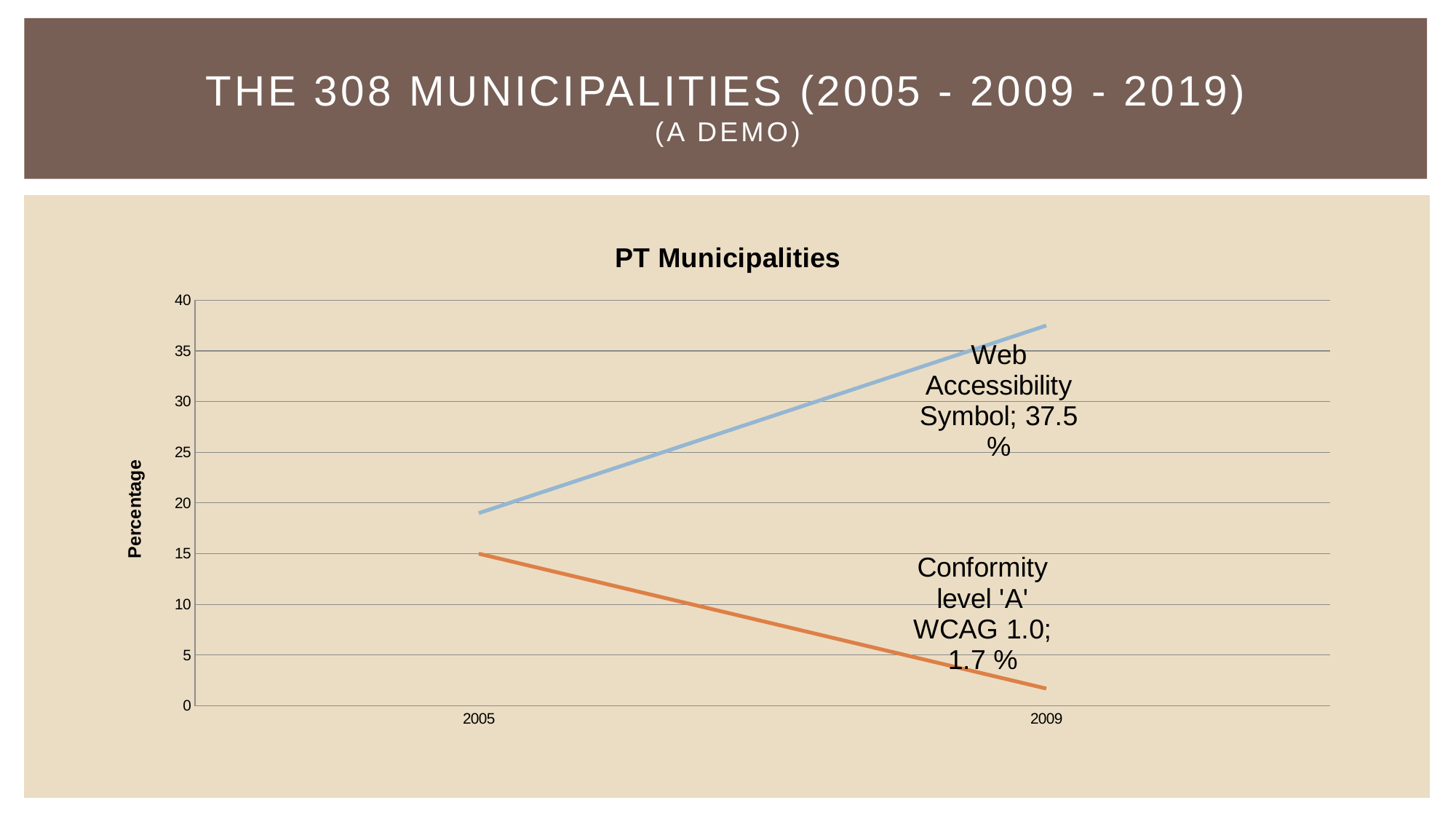
Does the Conformity level 'A' WCAG 1.0 line rise or fall from 2005 to 2009? falls Is the value for Conformity level 'A' WCAG 1.0 in 2005 greater or less than 10? greater How many years are shown on the x axis? 2 Is the value for Web Accessibility Symbol in 2005 greater or less than 15? greater What kind of chart is shown on the slide? line chart In 2009, which series has the larger value: Web Accessibility Symbol or Conformity level 'A' WCAG 1.0? Web Accessibility Symbol Is the value for Web Accessibility Symbol in 2005 greater or less than 25? less What is the value for Conformity level 'A' WCAG 1.0 in 2009? 1.7 % What is the value for Web Accessibility Symbol in 2009? 37.5 % What is the difference between the 2009 values of Web Accessibility Symbol and Conformity level 'A' WCAG 1.0? 35.8 % Does the Web Accessibility Symbol line rise or fall from 2005 to 2009? rises What is the title of the chart? PT Municipalities